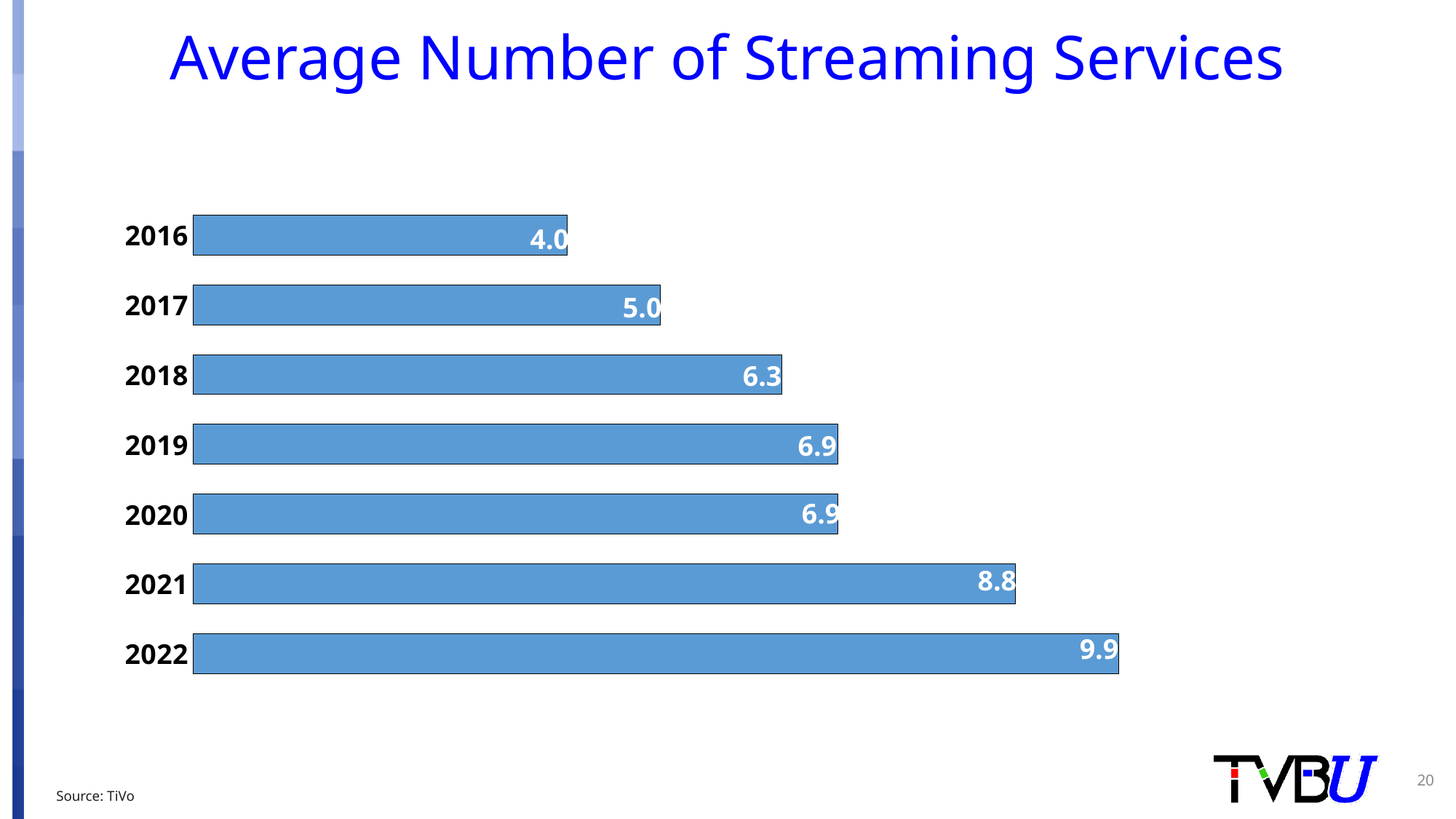
Which year has the highest average number of streaming services? 2022 What kind of chart is shown on the slide? bar chart Which is larger, the value for 2017 or the value for 2018? 2018 How many years are shown in the chart? 7 What is the value shown for 2021? 8.8 What is the difference between the values for 2022 and 2016? 5.9 What is the difference between the values for 2021 and 2020? 1.9 What is the value shown for 2018? 6.3 Which year has the lowest average number of streaming services? 2016 What is the title of the chart? Average Number of Streaming Services What is the average number of streaming services shown for 2016? 4.0 Do the values rise or fall from 2016 to 2022? rise